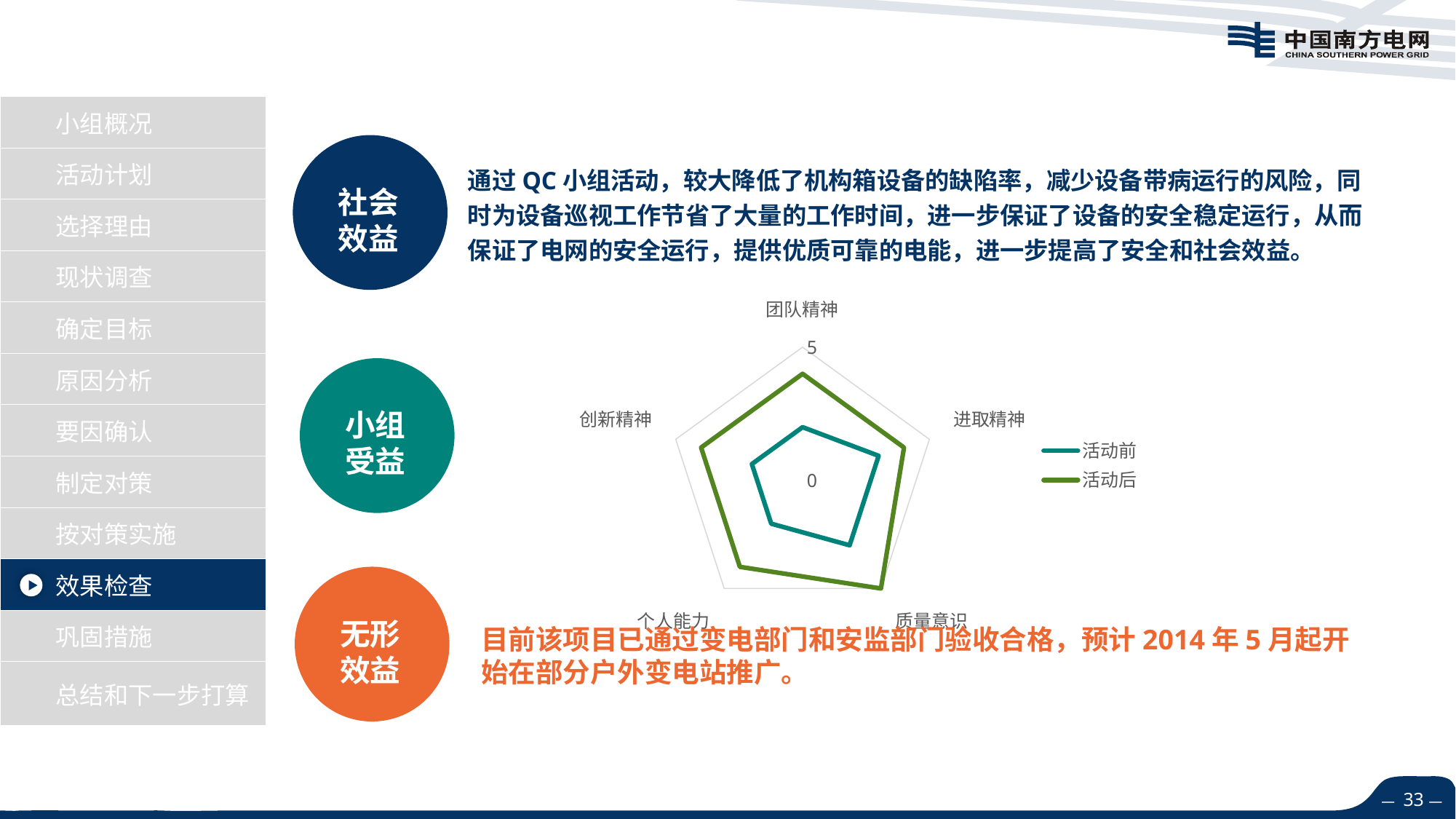
For 团队精神, which series has the larger value, 活动前 or 活动后? 活动后 What are the two series named in the legend of the radar chart? 活动前 and 活动后 For 创新精神, which series has the larger value, 活动前 or 活动后? 活动后 How many categories (axes) does the radar chart have? 5 How many series does the legend of the radar chart list? 2 For 质量意识, which series has the larger value, 活动前 or 活动后? 活动后 Is the 活动后 value for 进取精神 greater or less than 5? less What kind of chart is shown on the slide? radar chart Is the 活动前 value for 团队精神 greater or less than 0? greater What is the maximum value shown on the radar chart's axis scale? 5 Which series is drawn in green on the radar chart? 活动后